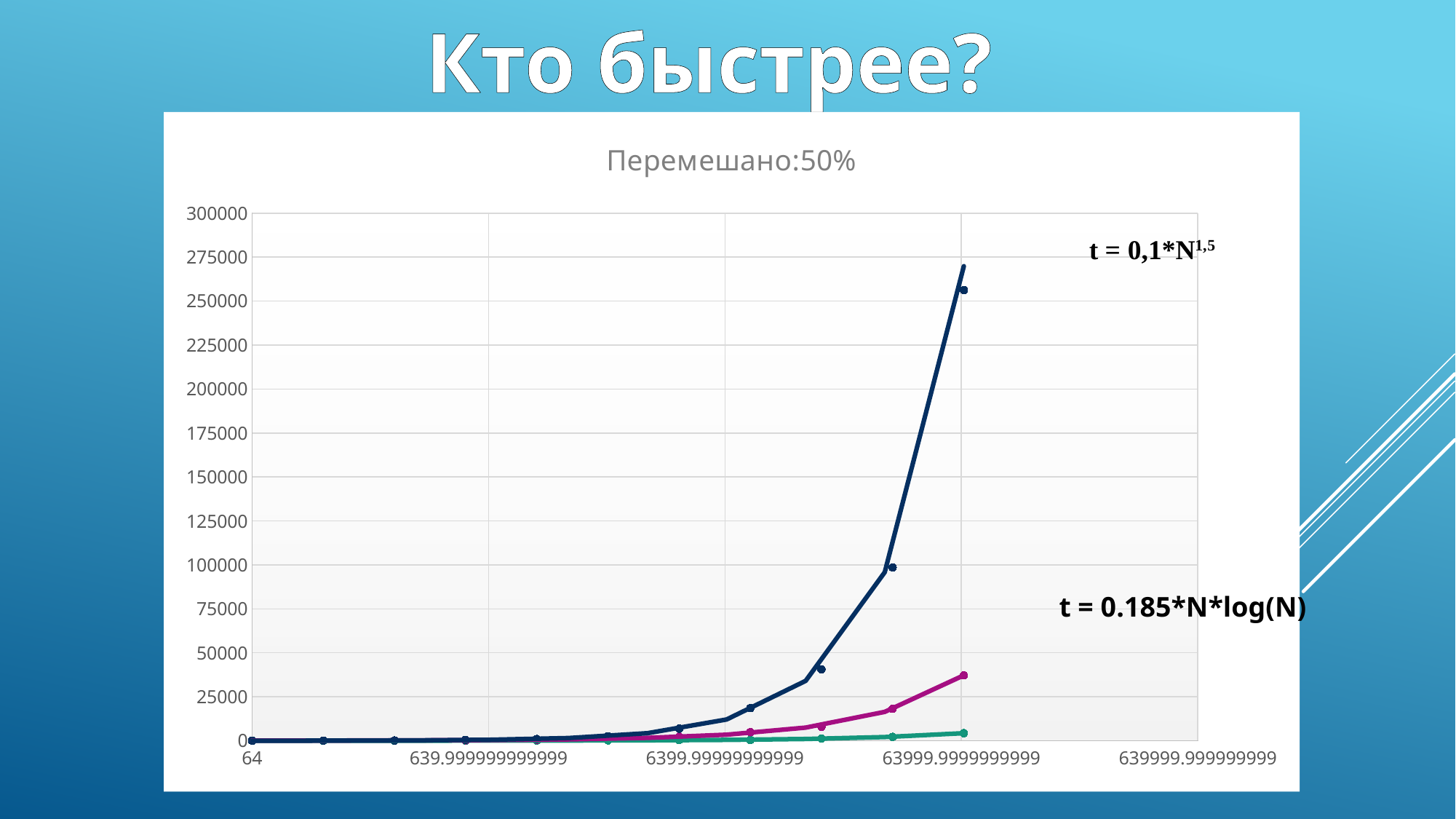
Which line reaches the highest value on the chart: the dark blue, the magenta, or the green one? dark blue Do the values of the dark blue line rise or fall as N increases along the x axis? rise Is the highest value of the green line greater or less than 25000? less What kind of chart is shown on the slide? line chart What is the title of the chart? Перемешано:50% What is the highest value shown on the y axis? 300000 Is the highest value of the dark blue line greater or less than 200000? greater How many tick labels are shown on the x axis? 5 Is the highest value of the magenta line greater or less than 50000? less Which line stays lowest across the chart: the dark blue, the magenta, or the green one? green At the rightmost data point, which line has the larger value: the dark blue or the magenta? dark blue How many lines (series) are plotted on the chart? 3